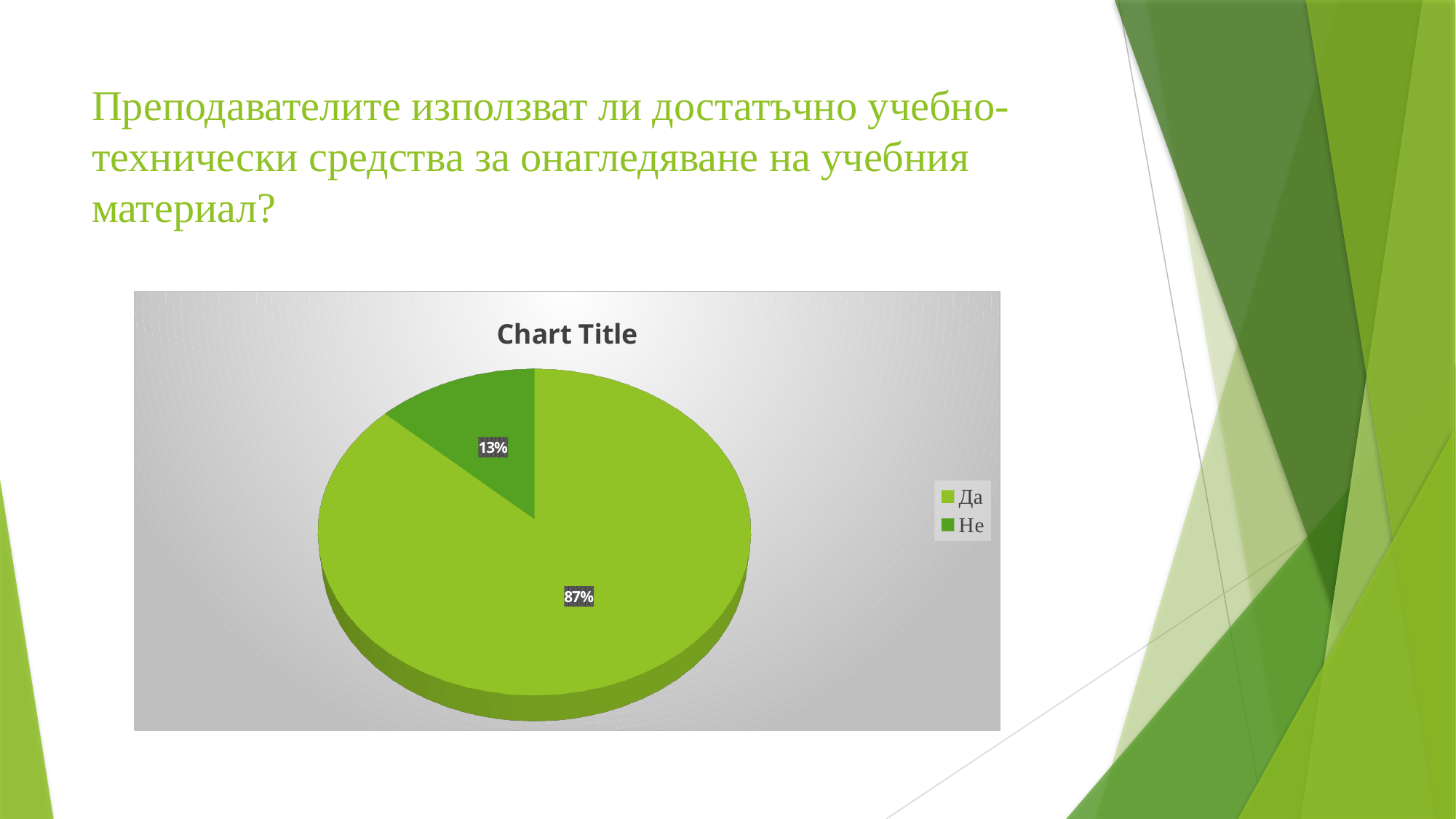
What share of the pie does "Да" represent? 87% What share of the pie does "Не" represent? 13% How many entries does the legend list? 2 What is the difference in percentage points between the "Да" and "Не" slices? 74 What kind of chart is shown on the slide? pie chart Which is larger, the "Да" slice or the "Не" slice? Да What is the title shown on the chart? Chart Title Which category has the smallest slice of the pie? Не How many categories does the pie chart show? 2 Which legend entry is shown in the darker green colour? Не Which category has the largest slice of the pie? Да